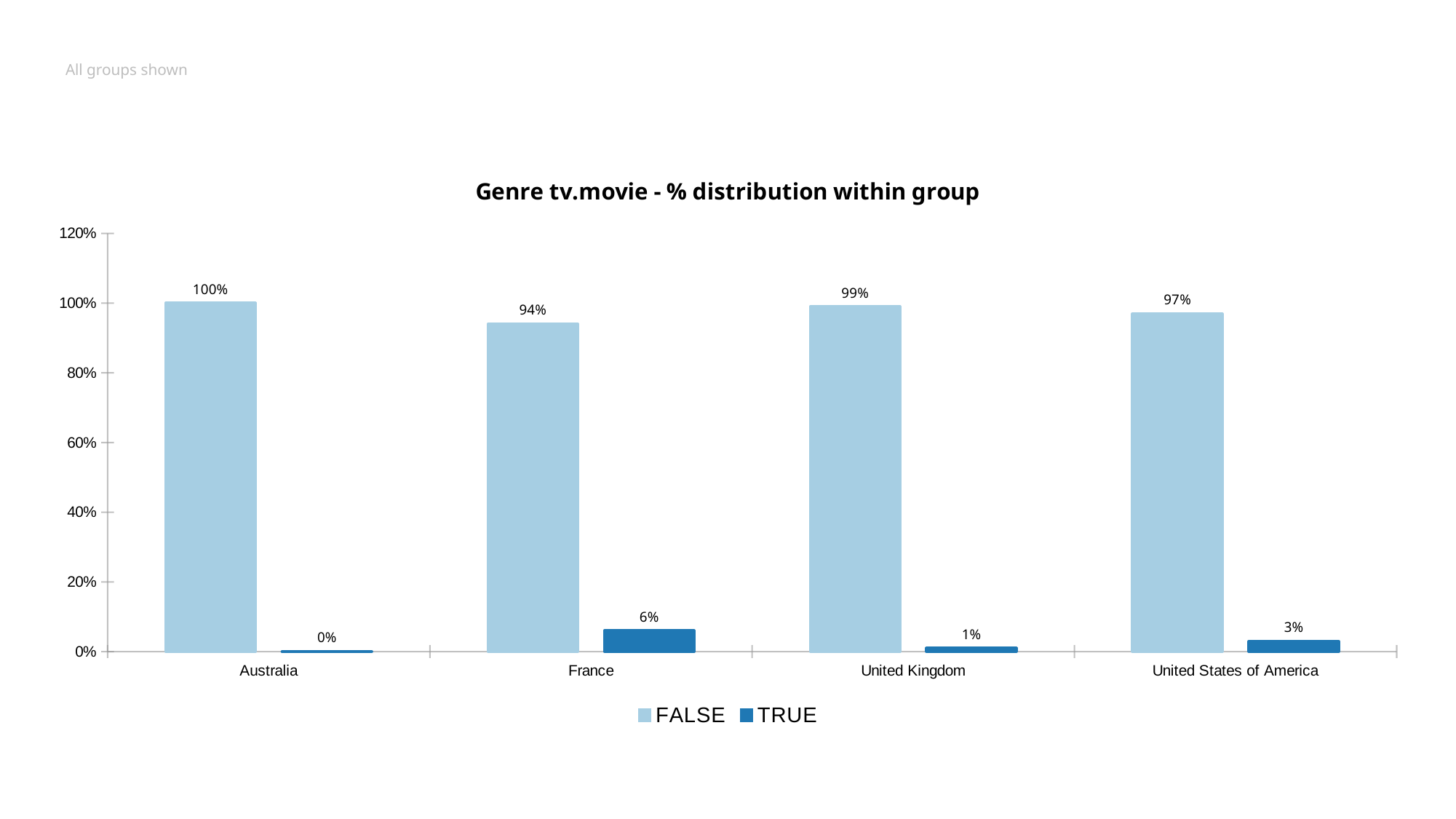
Which country has the highest TRUE value? France What is the difference between the FALSE values for Australia and the United States of America? 3% How many countries are shown on the x axis? 4 How many series does the legend list? 2 Which is larger, the TRUE value for the United Kingdom or the TRUE value for the United States of America? United States of America What is the TRUE value for the United States of America? 3% What kind of chart is shown? Bar chart Which country has the lowest FALSE value? France What is the FALSE value for France? 94% What is the TRUE value for Australia? 0% What is the title of the chart? Genre tv.movie - % distribution within group What is the FALSE value for the United Kingdom? 99%